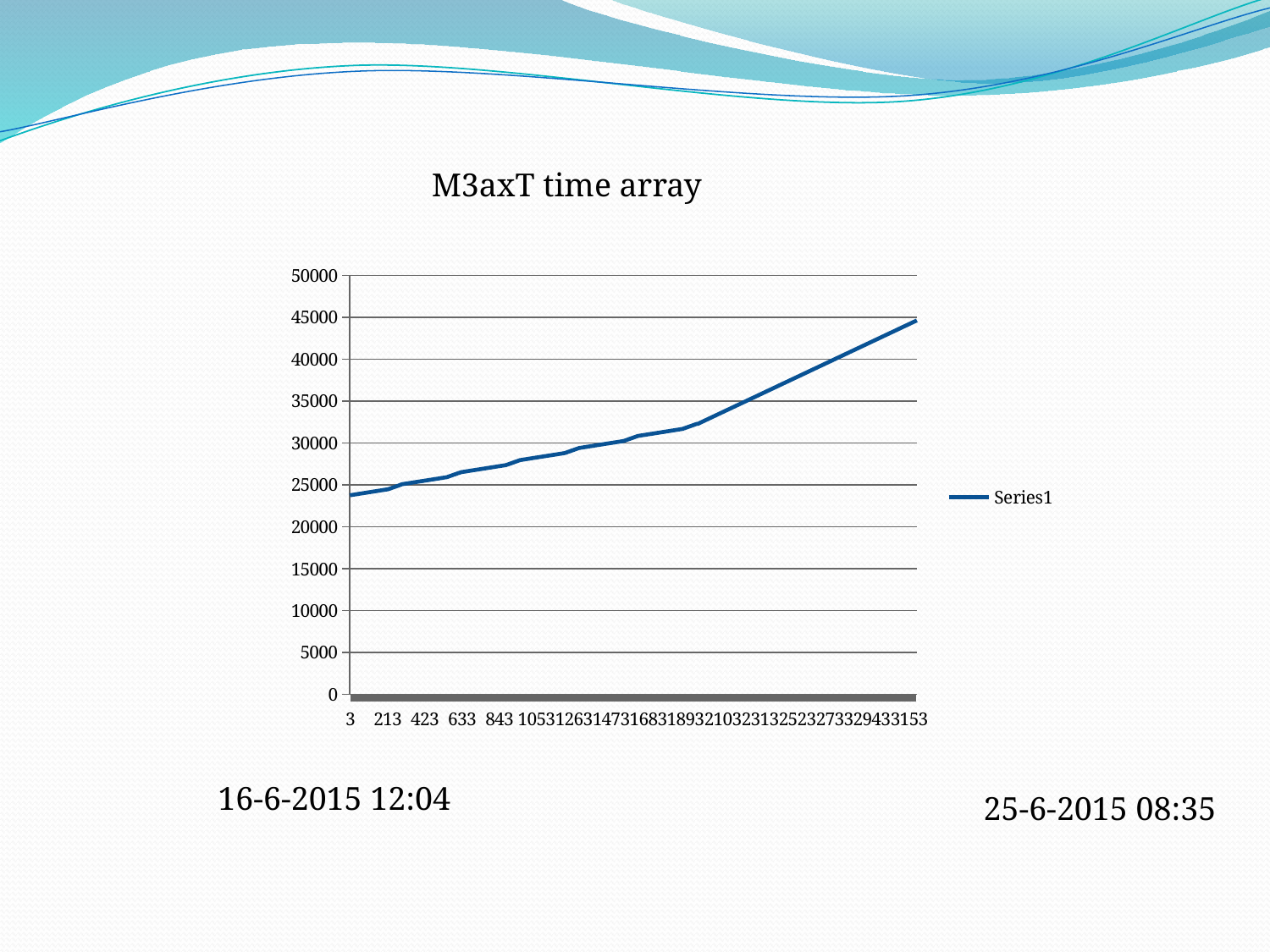
At which x-axis label does Series1 have its lowest value? 3 Do the values of Series1 rise or fall along the x axis? rise What kind of chart is shown on the slide? line chart What is the name of the series shown in the legend? Series1 Which is larger, the value of Series1 at x = 633 or at x = 2523? 2523 How many labels are shown on the x axis? 16 Is the value for Series1 at x = 3 greater or less than 25000? less How many series does the legend list? 1 Is the value for Series1 at x = 3153 greater or less than 40000? greater Is the value for Series1 at x = 1893 greater or less than 30000? greater What is the title of the chart? M3axT time array At which x-axis label does Series1 reach its highest value? 3153